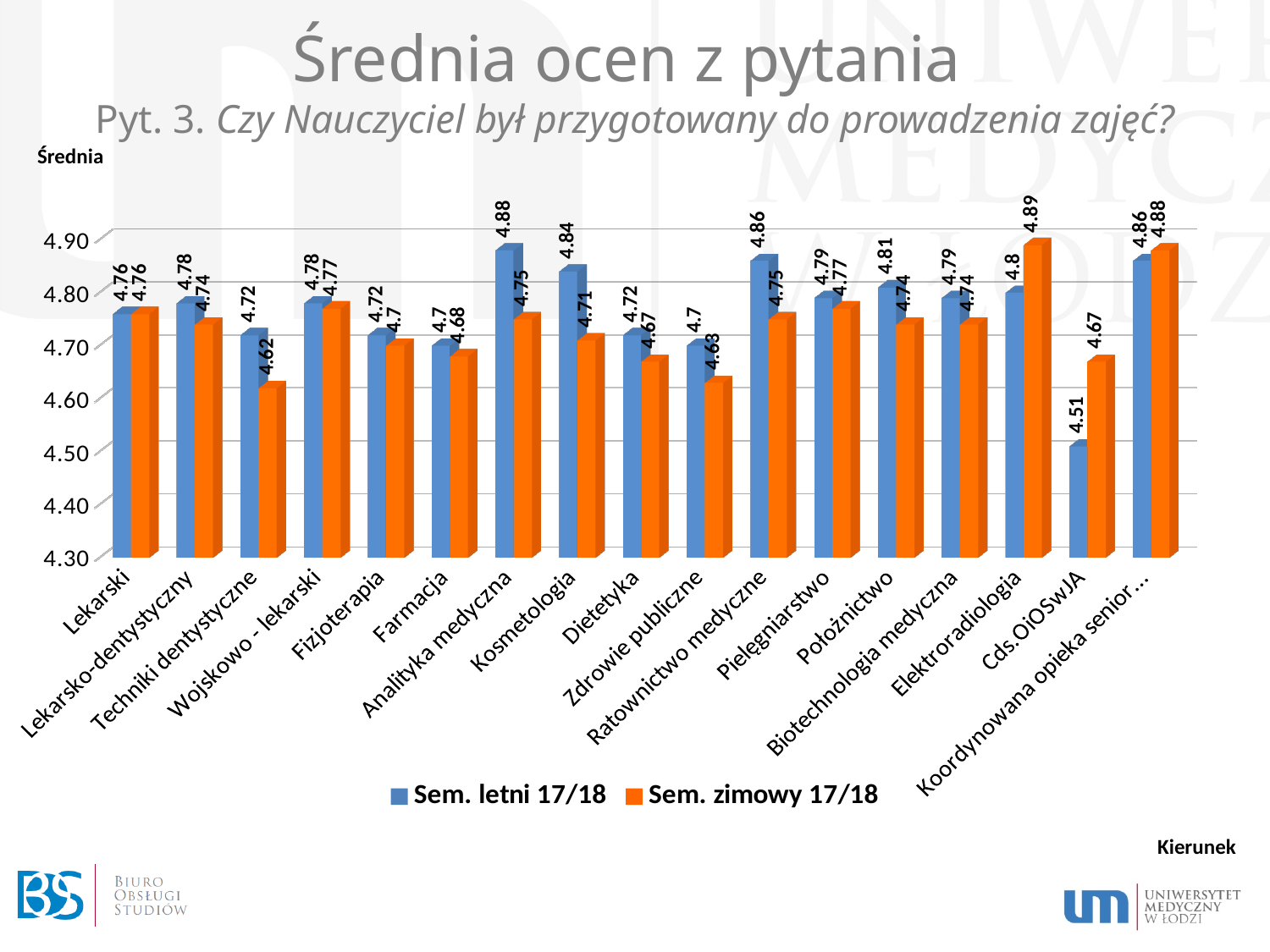
How many series does the legend list? 2 What is the value for Analityka medyczna in the Sem. letni 17/18 series? 4.88 Which category has the lowest value in the Sem. letni 17/18 series? Cds.OiOSwJA What kind of chart is shown on the slide? Bar chart What is the difference between the Sem. letni 17/18 and Sem. zimowy 17/18 values for Kosmetologia? 0.13 Which category has the lowest value in the Sem. zimowy 17/18 series? Techniki dentystyczne Which category has the highest value in the Sem. letni 17/18 series? Analityka medyczna What is the value for Elektroradiologia in the Sem. zimowy 17/18 series? 4.89 Which colour represents the Sem. zimowy 17/18 series? Orange For Cds.OiOSwJA, which series has the larger value: Sem. letni 17/18 or Sem. zimowy 17/18? Sem. zimowy 17/18 How many categories (kierunki) are shown on the x axis? 17 What is the value for Techniki dentystyczne in the Sem. zimowy 17/18 series? 4.62